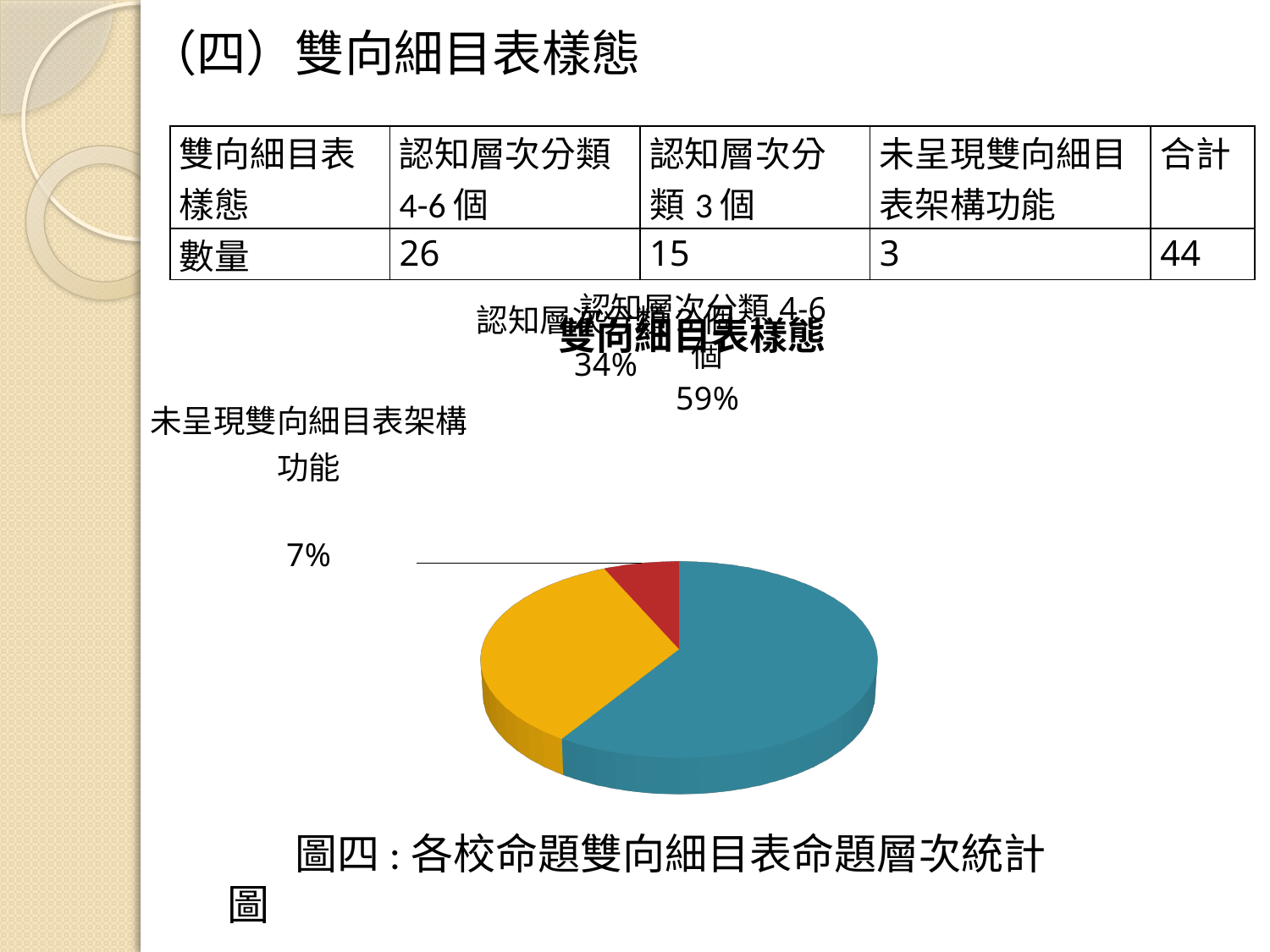
Which is larger in the pie chart: 認知層次分類 3 個 or 未呈現雙向細目表架構功能? 認知層次分類 3 個 What share of the pie does 認知層次分類 4-6 個 take? 59% By how many percentage points does the share of 認知層次分類 3 個 exceed that of 未呈現雙向細目表架構功能? 27% By how many percentage points does the share of 認知層次分類 4-6 個 exceed that of 認知層次分類 3 個? 25% Which category has the smallest slice of the pie? 未呈現雙向細目表架構功能 What share of the pie does 未呈現雙向細目表架構功能 take? 7% How many slices does the pie chart have? 3 Which category has the largest slice of the pie? 認知層次分類 4-6 個 What colour is the largest slice of the pie chart? teal blue What is the title of the pie chart? 雙向細目表樣態 What kind of chart is shown on the slide? pie chart What share of the pie does 認知層次分類 3 個 take? 34%